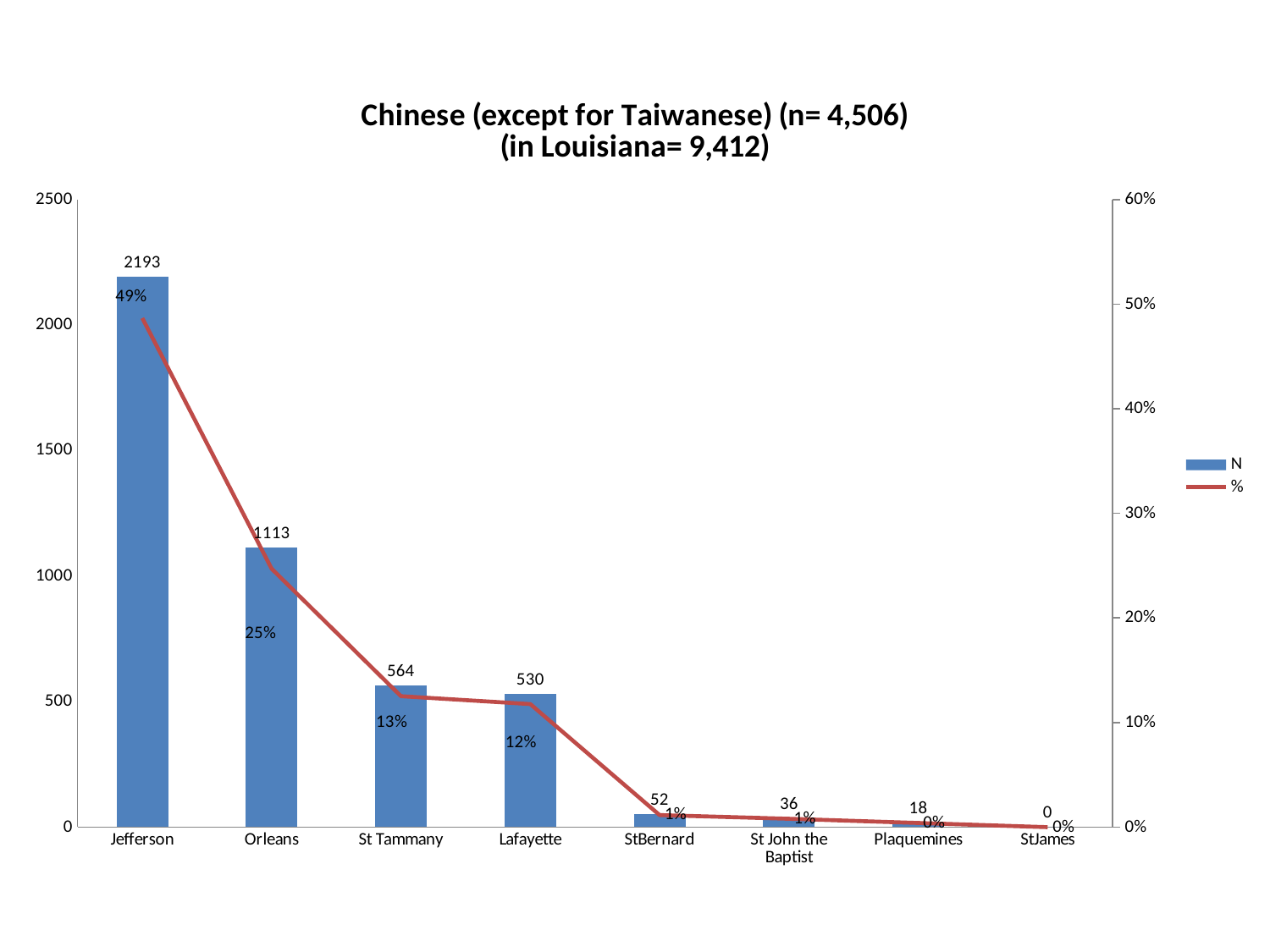
Do the N values rise or fall from left to right along the x axis? fall Which has a larger N value, St Tammany or Lafayette? St Tammany Which parish has the lowest N value? StJames What is the N value for Jefferson? 2193 What is the title of the chart? Chinese (except for Taiwanese) (n= 4,506) (in Louisiana= 9,412) How many parishes are shown on the x axis? 8 How many series does the legend list? 2 What is the difference in N between Jefferson and Orleans? 1080 Which parish has the highest N value? Jefferson What is the N value for Orleans? 1113 What percentage is shown for St Tammany? 13% What is the N value for St John the Baptist? 36